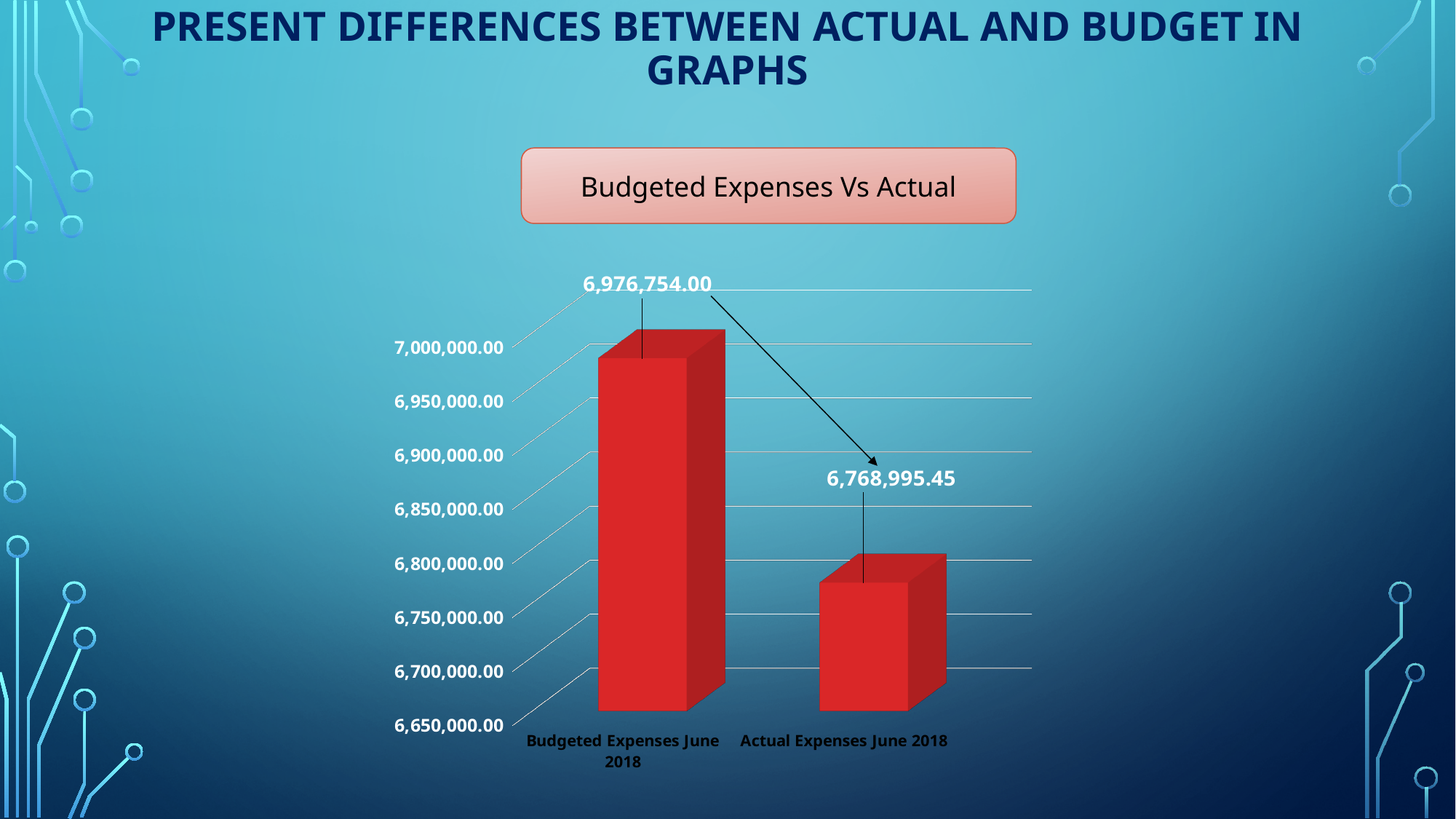
Is the value for Actual Expenses June 2018 greater or less than 6,800,000.00? less What kind of chart is shown on the slide? bar chart Which category has the highest value? Budgeted Expenses June 2018 Which is larger, Budgeted Expenses June 2018 or Actual Expenses June 2018? Budgeted Expenses June 2018 What is the title of the chart? Budgeted Expenses Vs Actual Which category has the lowest value? Actual Expenses June 2018 What is the difference between Budgeted Expenses June 2018 and Actual Expenses June 2018? 207,758.55 What is the value for Budgeted Expenses June 2018? 6,976,754.00 What is the value for Actual Expenses June 2018? 6,768,995.45 How many categories are shown in the chart? 2 Is the value for Budgeted Expenses June 2018 greater or less than 6,950,000.00? greater What is the lowest value shown on the vertical axis? 6,650,000.00